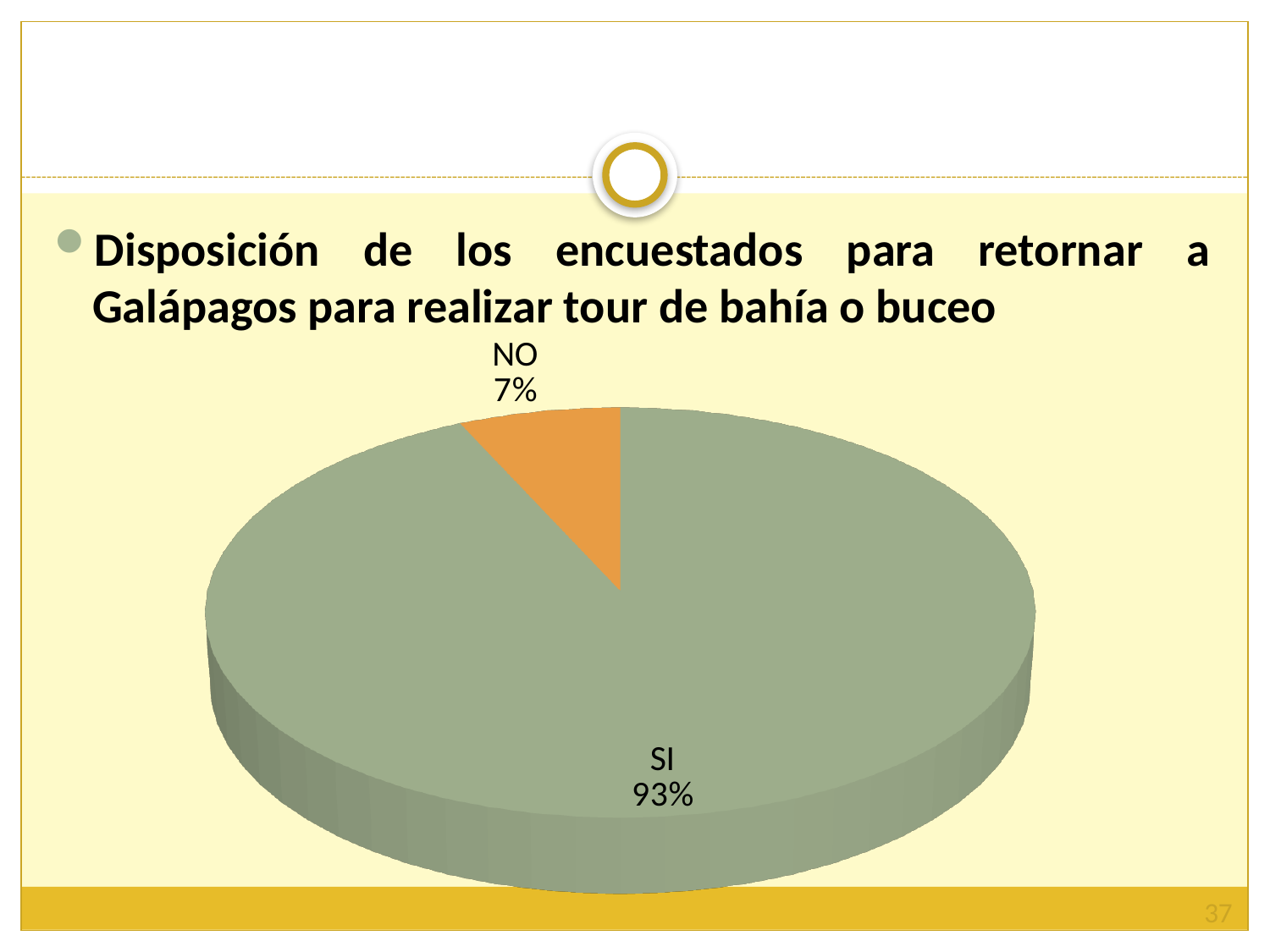
How many slices does the pie chart have? 2 What percentage of respondents answered SI? 93% Which category has the largest share of the pie? SI What percentage of respondents answered NO? 7% Which slice is larger, SI or NO? SI Which category has the smallest share of the pie? NO What is the text above the chart describing what it shows? Disposición de los encuestados para retornar a Galápagos para realizar tour de bahía o buceo What colour is the NO slice? Orange What is the difference in percentage points between the SI and NO slices? 86 What kind of chart is shown on the slide? Pie chart What share of the pie does the NO slice represent? 7%